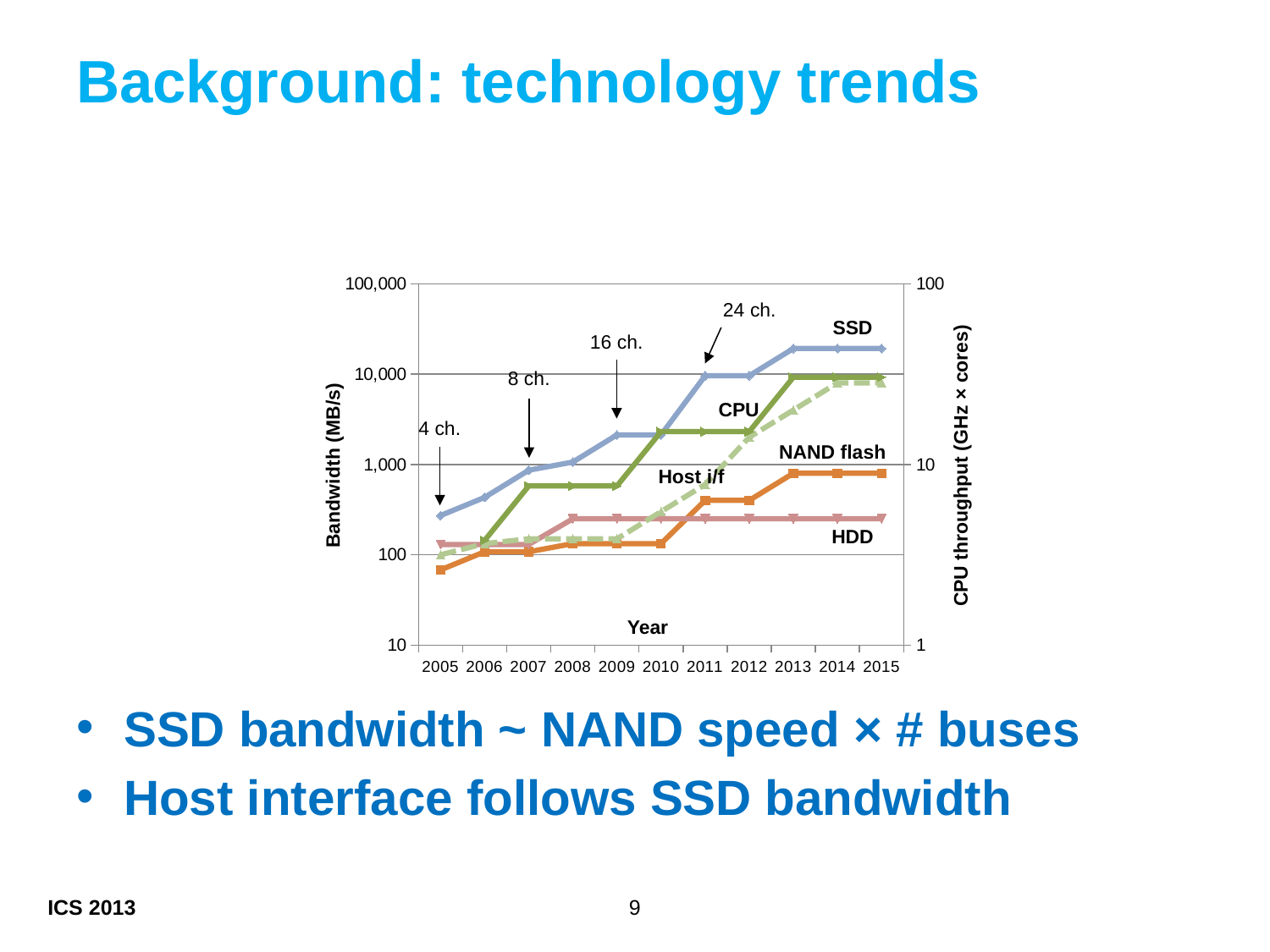
Does the SSD bandwidth rise or fall from 2005 to 2015? rise How many years are shown along the x axis of the chart? 11 Which series has the highest bandwidth in 2015? SSD Is the NAND flash bandwidth in 2005 greater or less than 100 MB/s? less How many data series are labelled on the chart? 5 Which series has the lowest value in 2015? HDD What is the title of the left vertical axis of the chart? Bandwidth (MB/s) Is the SSD bandwidth in 2005 greater or less than 1,000 MB/s? less What kind of chart is shown on the slide? line chart Is the SSD bandwidth in 2015 greater or less than 10,000 MB/s? greater In 2015, which is larger: the NAND flash bandwidth or the HDD bandwidth? NAND flash